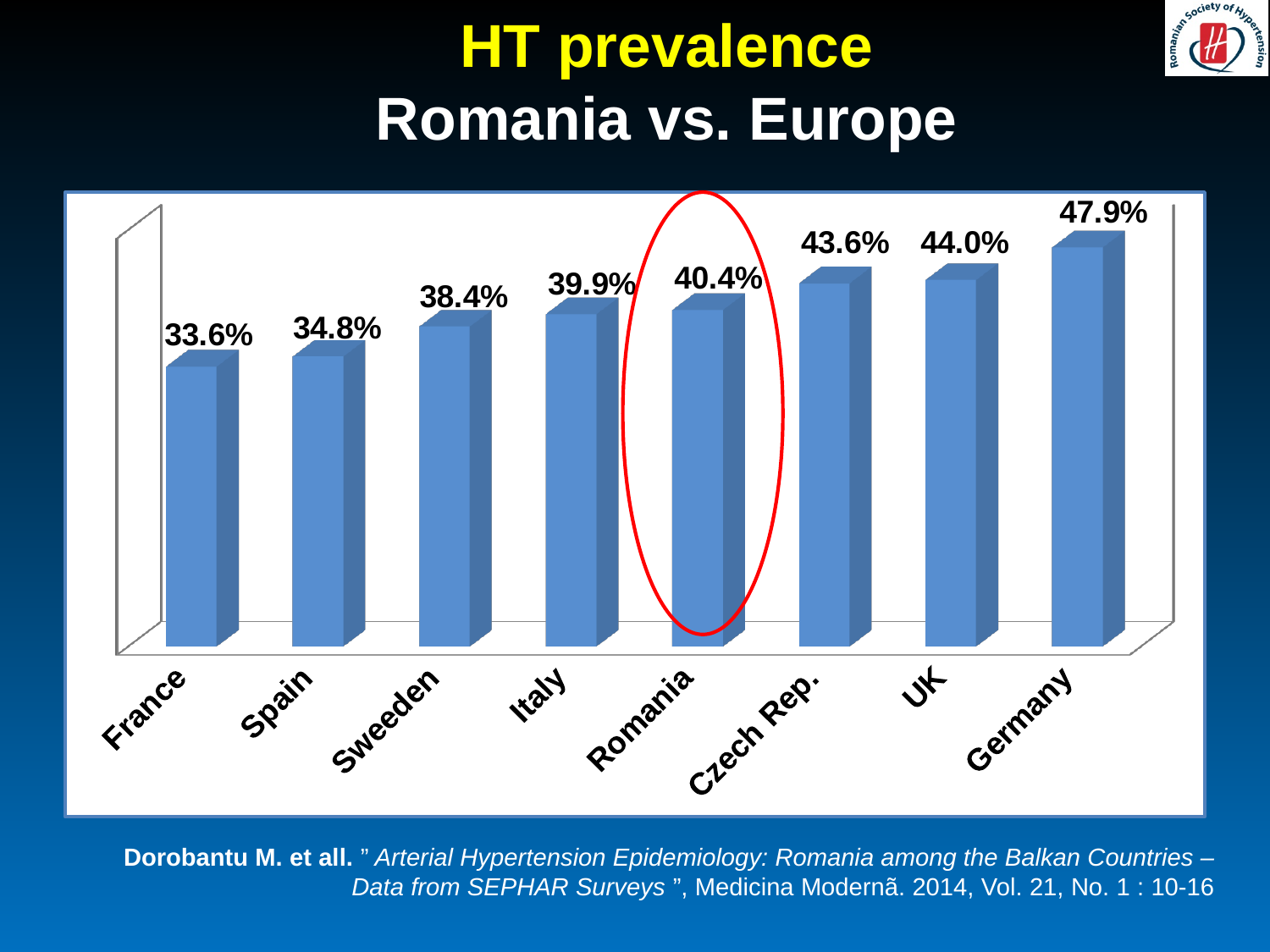
What is the HT prevalence value shown for Romania? 40.4% Which country has the lowest HT prevalence on the chart? France How many countries are shown on the chart? 8 What is the difference between the HT prevalence of Germany and Romania? 7.5% Which has a higher HT prevalence, Italy or Spain? Italy What is the HT prevalence value shown for Germany? 47.9% Which country's bar is circled in red on the chart? Romania Which country has the highest HT prevalence on the chart? Germany What is the difference between the HT prevalence of Romania and France? 6.8% What kind of chart is shown on the slide? Bar chart What is the HT prevalence value shown for Czech Rep.? 43.6% What is the HT prevalence value shown for France? 33.6%